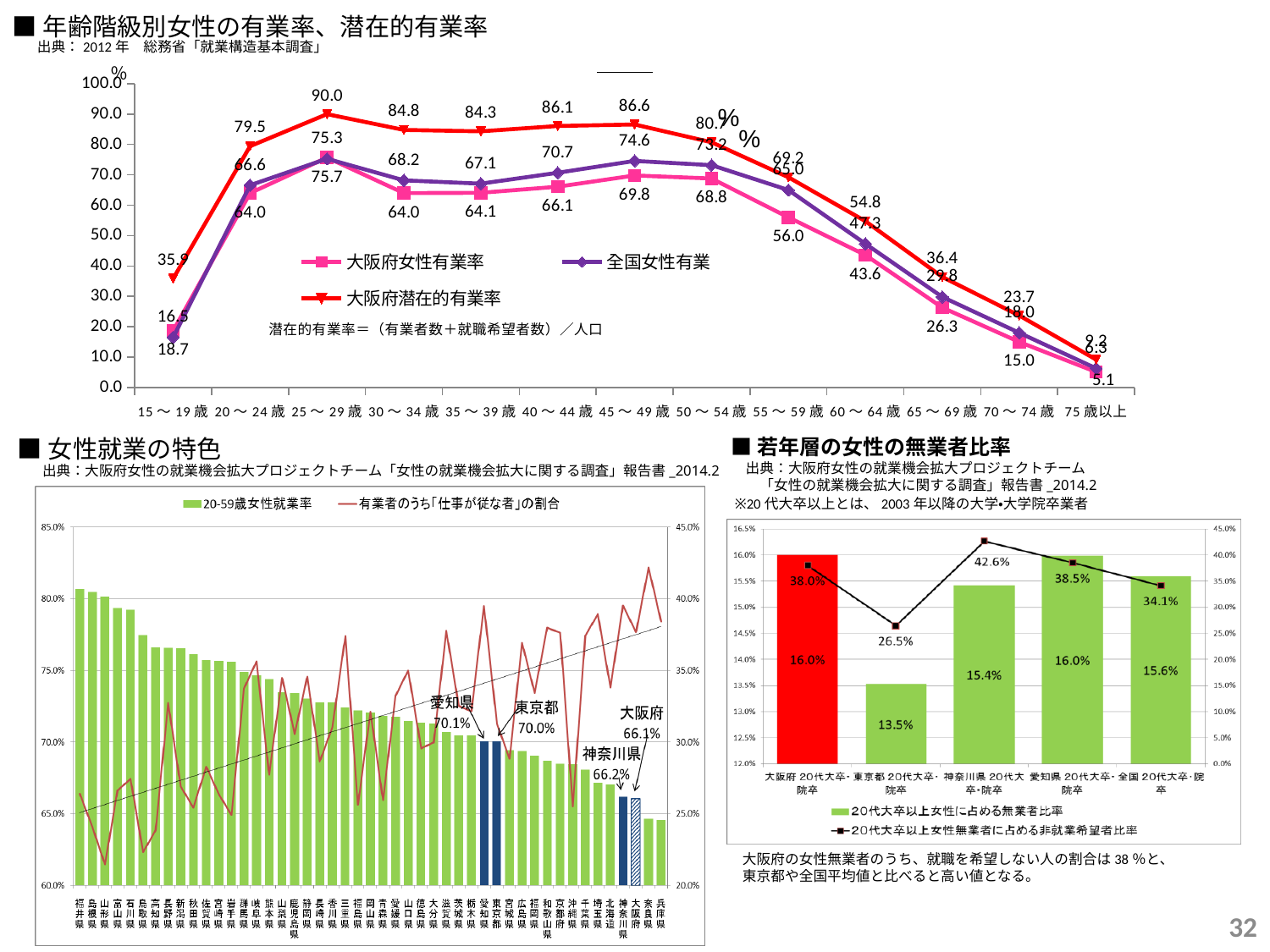
In the bottom-right chart 若年層の女性の無業者比率, which category has the highest 20代大卒以上女性無業者に占める非就業希望者比率? 神奈川県 20代大卒・院卒 In the bottom-right chart 若年層の女性の無業者比率, what is the 20代大卒以上女性に占める無業者比率 for 東京都? 13.5% In the top chart 年齢階級別女性の有業率、潜在的有業率, how many series does the legend list? 3 In the bottom-left chart 女性就業の特色, what is the 20-59歳女性就業率 value labelled for 大阪府? 66.1% In the top chart 年齢階級別女性の有業率、潜在的有業率, what is the value of 大阪府女性有業率 for 55～59歳? 56.0 In the top chart 年齢階級別女性の有業率、潜在的有業率, how many age groups are shown on the x axis? 13 In the top chart 年齢階級別女性の有業率、潜在的有業率, what is the value of 大阪府潜在的有業率 for 25～29歳? 90.0 In the bottom-right chart 若年層の女性の無業者比率, what is the difference between the 非就業希望者比率 for 大阪府 and 東京都? 11.5% In the top chart 年齢階級別女性の有業率、潜在的有業率, do the values of 大阪府女性有業率 rise or fall from 55～59歳 to 75歳以上? fall In the bottom-left chart 女性就業の特色, which is larger, the labelled value for 愛知県 or for 神奈川県? 愛知県 In the top chart 年齢階級別女性の有業率、潜在的有業率, which age group has the highest value for 大阪府潜在的有業率? 25～29歳 In the top chart 年齢階級別女性の有業率、潜在的有業率, what is the difference between 大阪府潜在的有業率 and 大阪府女性有業率 for 45～49歳? 16.8